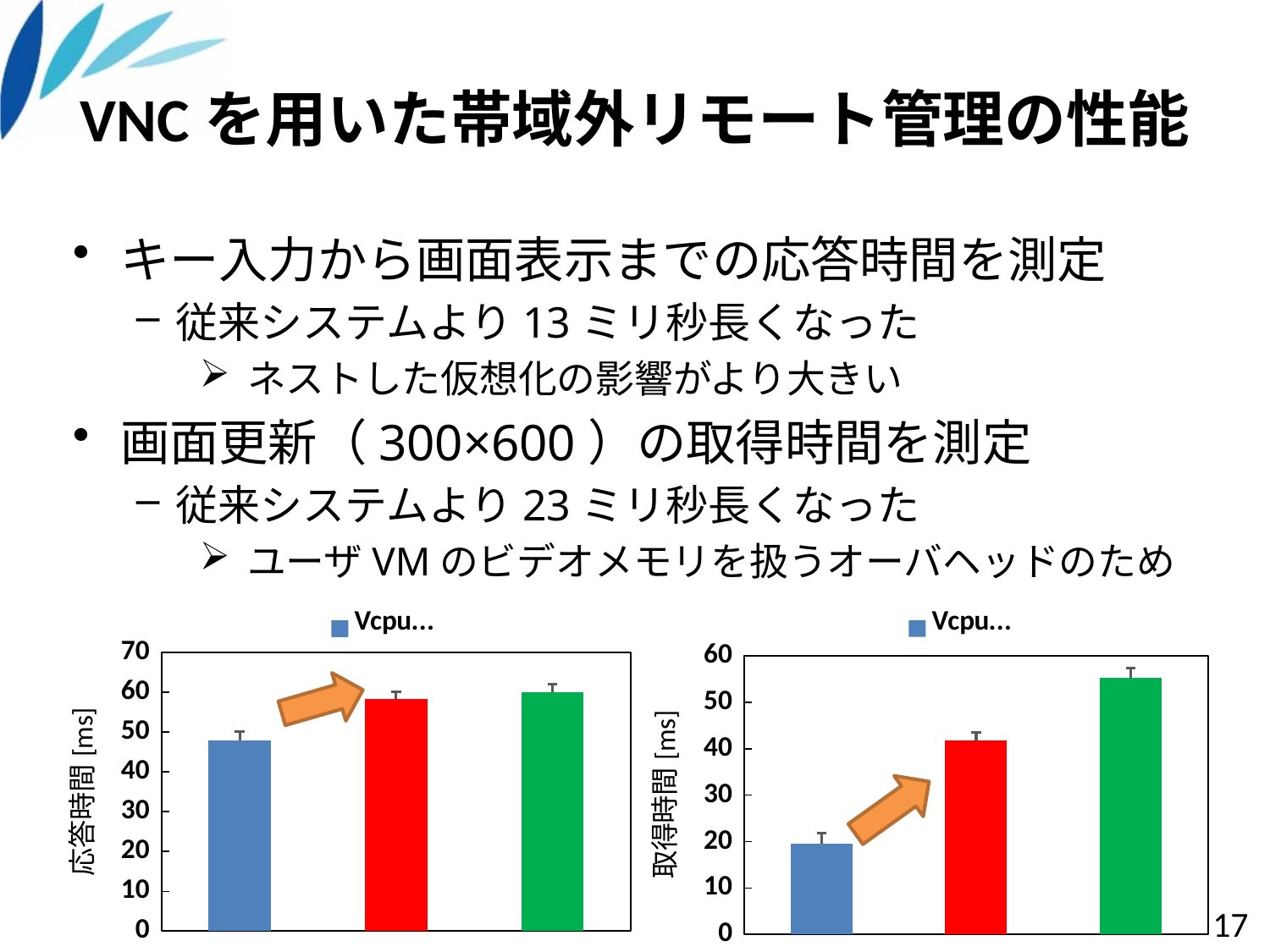
In the right chart (取得時間), is the value of the blue bar greater or less than 30? less What is the y-axis label of the right chart? 取得時間 [ms] In the left chart (応答時間), is the value of the blue bar greater or less than 40? greater How many bars are plotted in the left chart (応答時間)? 3 What kind of chart is the left chart on the slide? bar chart In the left chart (応答時間), which bar is the lowest: the blue, red or green one? blue In the right chart (取得時間), which bar is the highest: the blue, red or green one? green In the right chart (取得時間), is the value of the green bar greater or less than 50? greater How many bars are plotted in the right chart (取得時間)? 3 In the right chart (取得時間), do the bar values rise or fall from left to right? rise In the left chart (応答時間), which is larger, the blue bar or the red bar? red bar